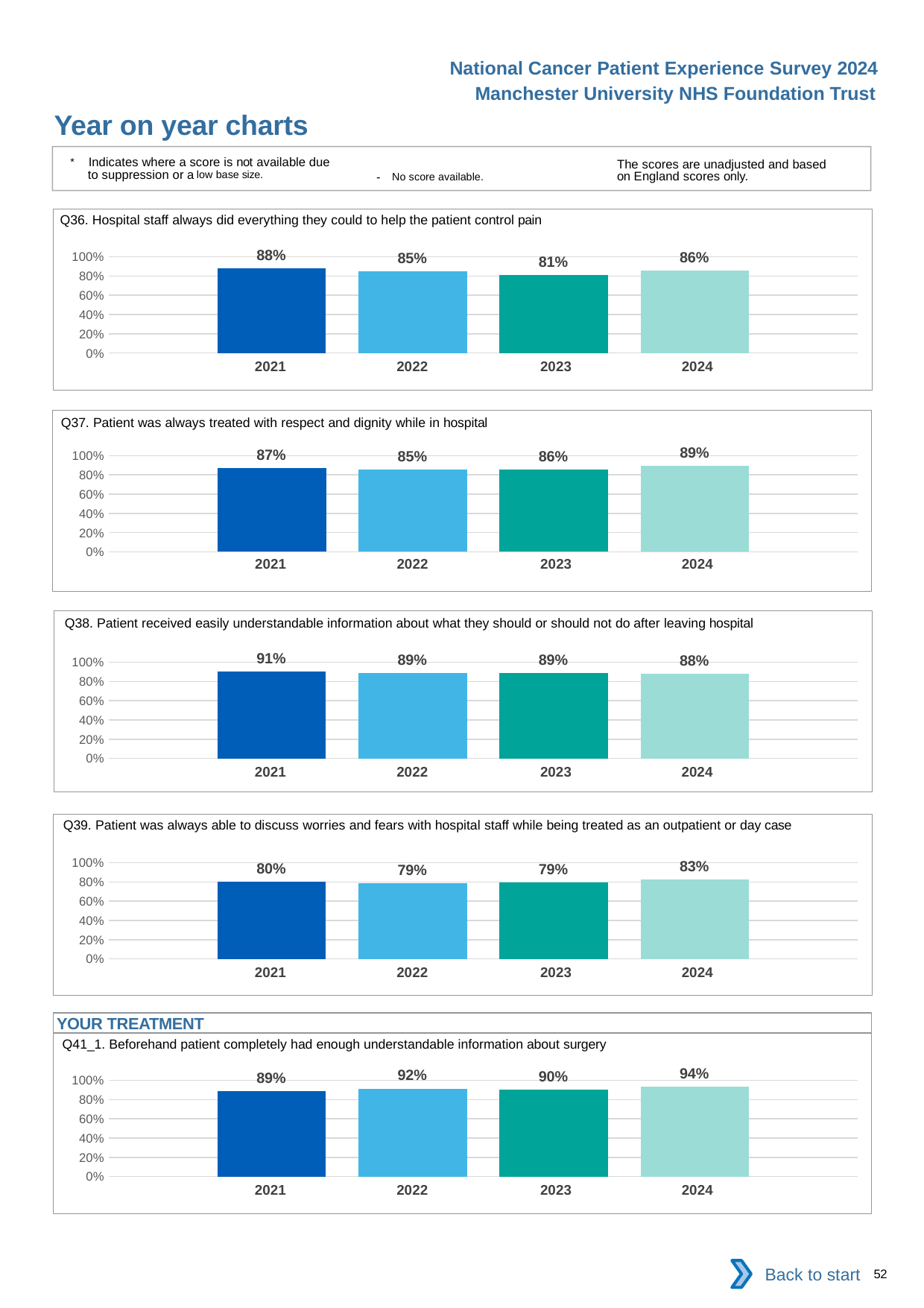
In the Q36 chart (hospital staff always did everything they could to help the patient control pain), what is the value for 2023? 81% In the Q39 chart, is the value for 2022 larger or smaller than the value for 2024? smaller How many years are shown on the x axis of the Q36 chart? 4 In the Q37 chart, which year has the lowest value? 2022 In the Q41_1 chart, which year has the highest value? 2024 What kind of chart is the Q37 chart? bar chart In the Q41_1 chart (enough understandable information about surgery), what is the value for 2022? 92% In the Q37 chart (patient was always treated with respect and dignity while in hospital), what is the value for 2024? 89% In the Q38 chart (easily understandable information after leaving hospital), what is the difference between the 2021 and 2024 values? 3 percentage points In the Q36 chart, which year has the highest value? 2021 In the Q38 chart, which year has the highest value? 2021 In the Q39 chart (discuss worries and fears as an outpatient or day case), what is the value for 2024? 83%